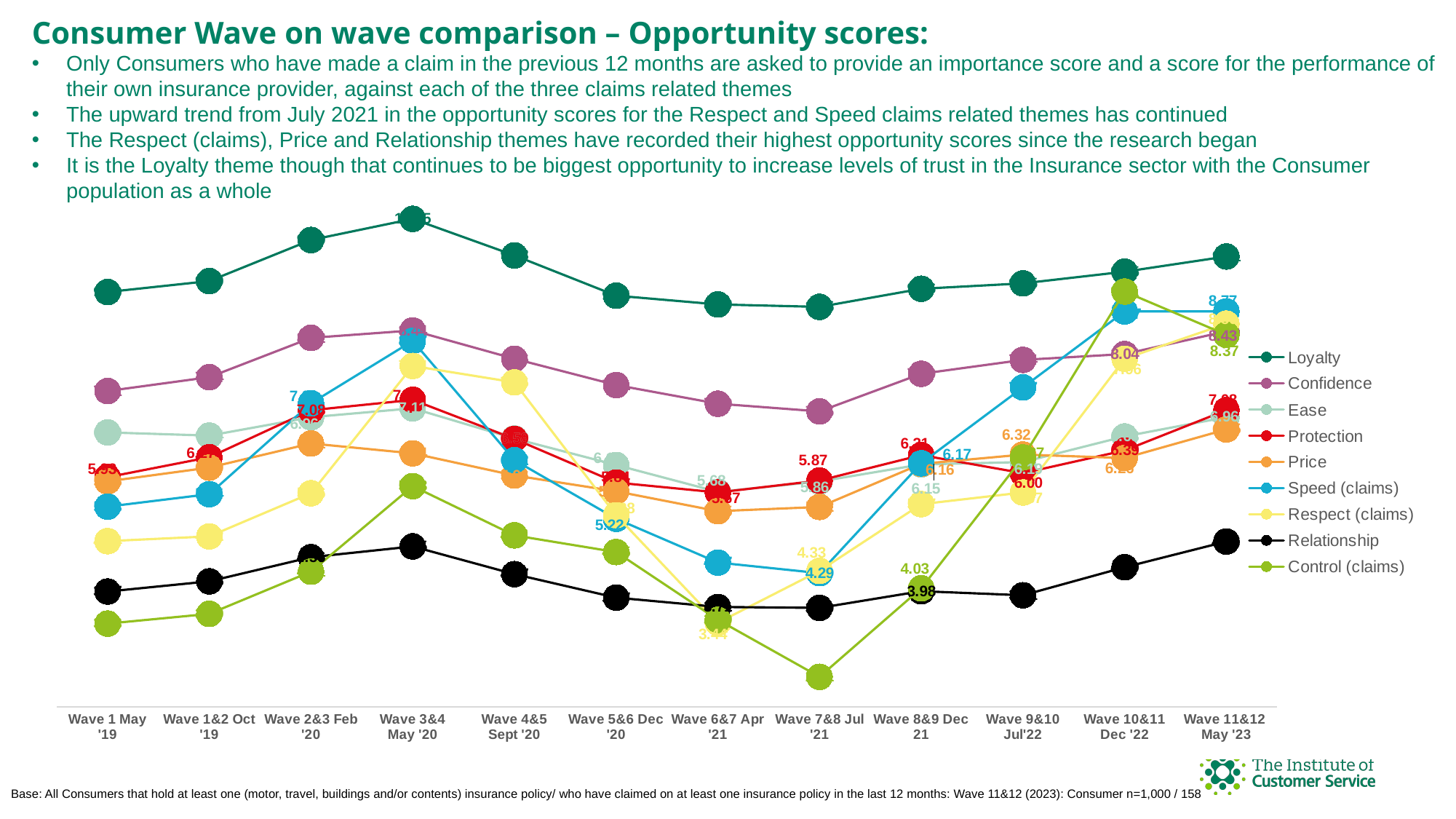
How many waves are shown along the x axis? 12 Which series has the lowest opportunity score at Wave 7&8 Jul '21? Control (claims) What is the Protection score at Wave 7&8 Jul '21? 5.87 What is the Control (claims) score at Wave 6&7 Apr '21? 3.49 Which series has the highest opportunity score at Wave 11&12 May '23? Loyalty How many series does the legend list? 9 What is the Price score at Wave 9&10 Jul'22? 6.32 What kind of chart is shown on the slide? line chart Does the Loyalty score rise or fall from Wave 7&8 Jul '21 to Wave 11&12 May '23? rise Which is larger at Wave 1 May '19, the Loyalty score or the Relationship score? Loyalty What is the difference between the Control (claims) score (4.03) and the Relationship score (3.98) at Wave 8&9 Dec 21? 0.05 What is the Confidence score at Wave 10&11 Dec '22? 8.04